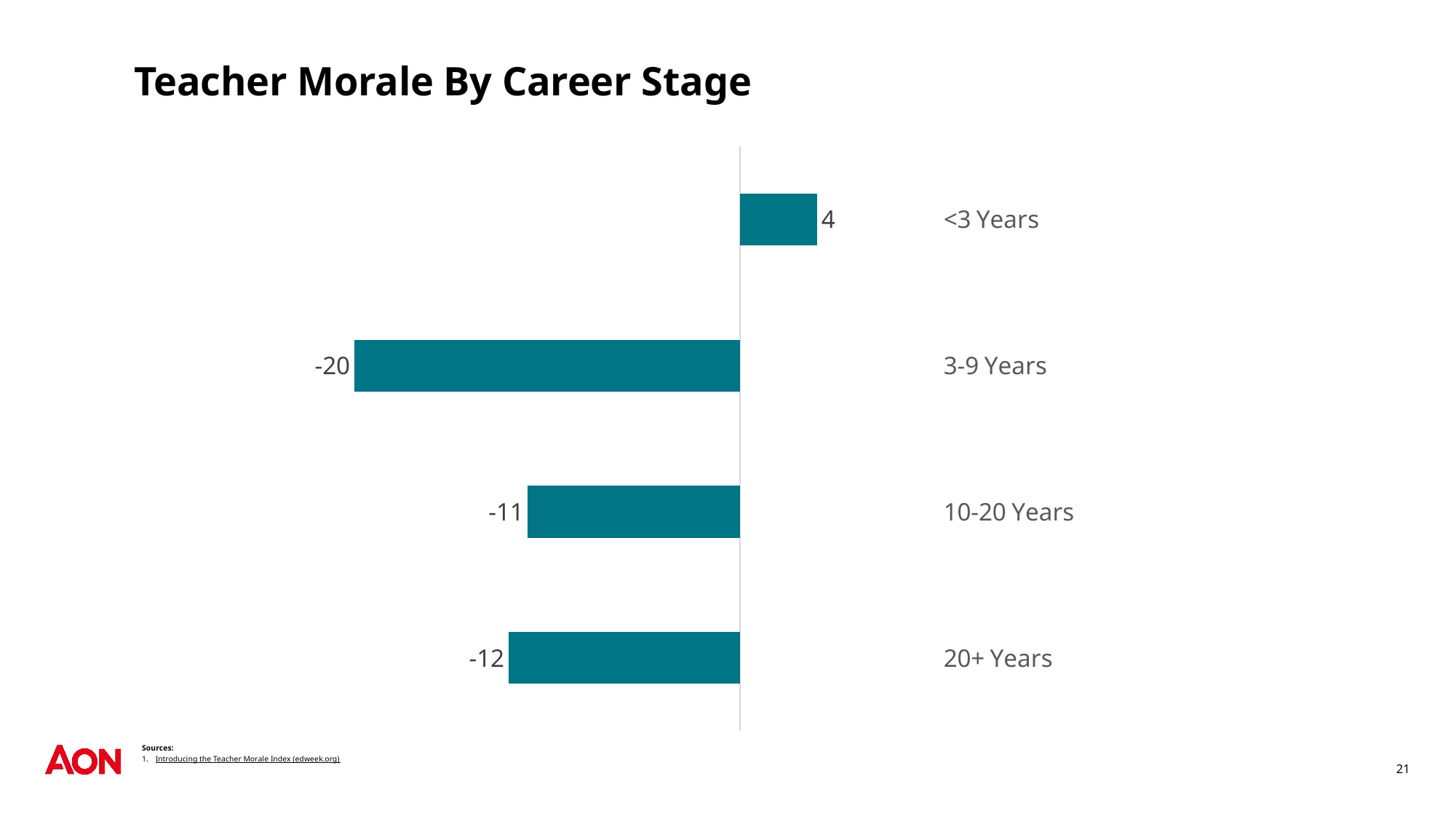
What is the difference between the teacher morale values for <3 Years and 3-9 Years? 24 What kind of chart is shown on the slide? Bar chart Which career stage has the highest teacher morale value? <3 Years Which career stage has the lowest teacher morale value? 3-9 Years What is the title of the chart on the slide? Teacher Morale By Career Stage What is the teacher morale value for the 10-20 Years career stage? -11 What is the difference between the teacher morale values for 10-20 Years and 20+ Years? 1 What is the teacher morale value for the 3-9 Years career stage? -20 Which has a higher teacher morale value, 10-20 Years or 3-9 Years? 10-20 Years How many career stages are shown in the chart? 4 What is the teacher morale value for the <3 Years career stage? 4 What is the teacher morale value for the 20+ Years career stage? -12